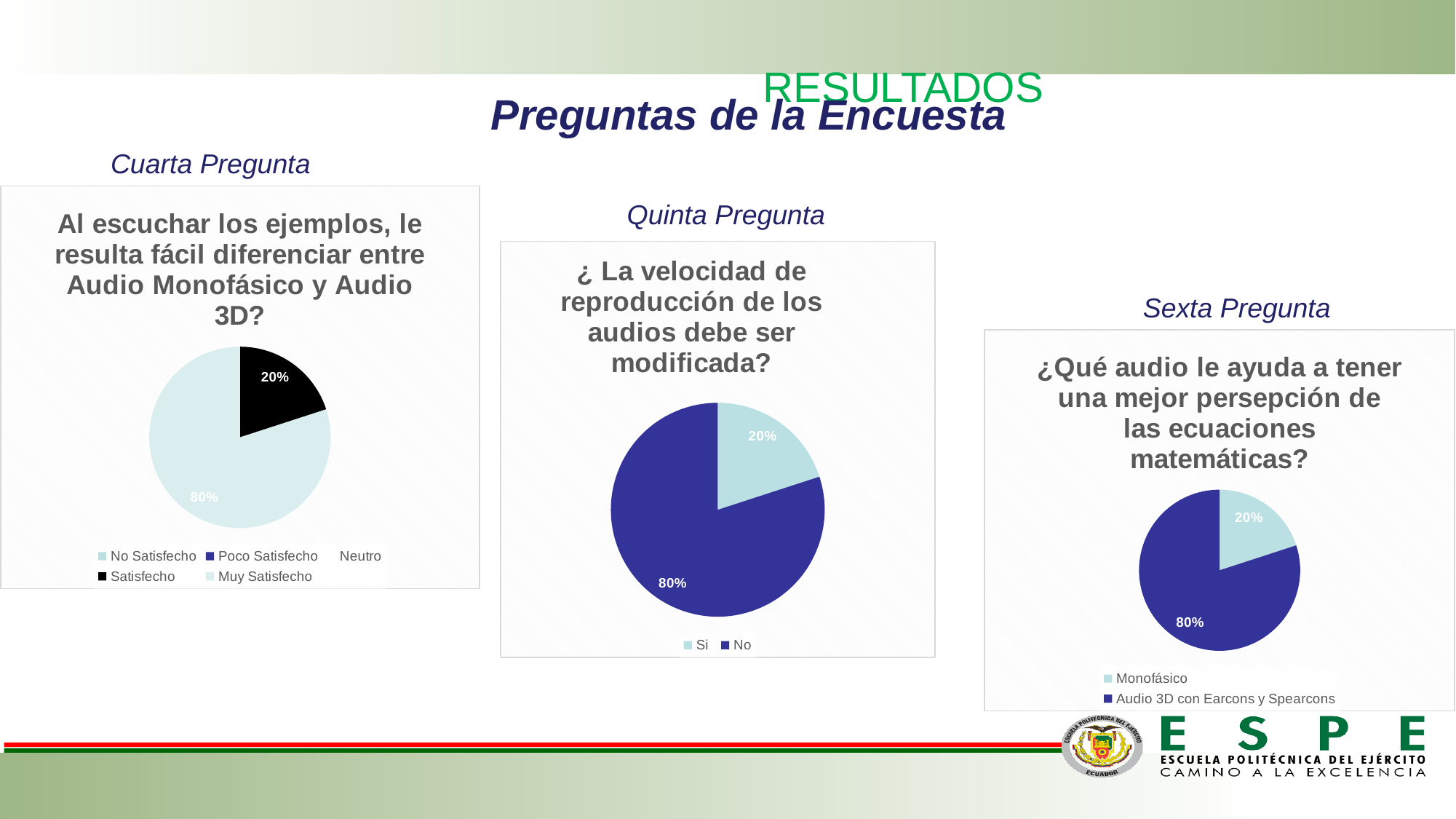
In the Quinta Pregunta chart, what percentage answered Si? 20% In the Quinta Pregunta chart, what percentage answered No? 80% In the Cuarta Pregunta chart, what share of the pie is Muy Satisfecho? 80% How many entries does the legend of the Cuarta Pregunta chart list? 5 In the Quinta Pregunta chart, what is the difference between the No share and the Si share? 60% How many entries does the legend of the Quinta Pregunta chart list? 2 In the Cuarta Pregunta chart, what share of the pie is labelled Satisfecho (the black slice)? 20% In the Sexta Pregunta chart, which category has the largest share? Audio 3D con Earcons y Spearcons In the Sexta Pregunta chart, what share is labelled Monofásico? 20% In the Quinta Pregunta chart, which answer has the larger share, Si or No? No In the Sexta Pregunta chart, what colour is the Audio 3D con Earcons y Spearcons slice? Dark blue What kind of chart is used for the Cuarta Pregunta? Pie chart